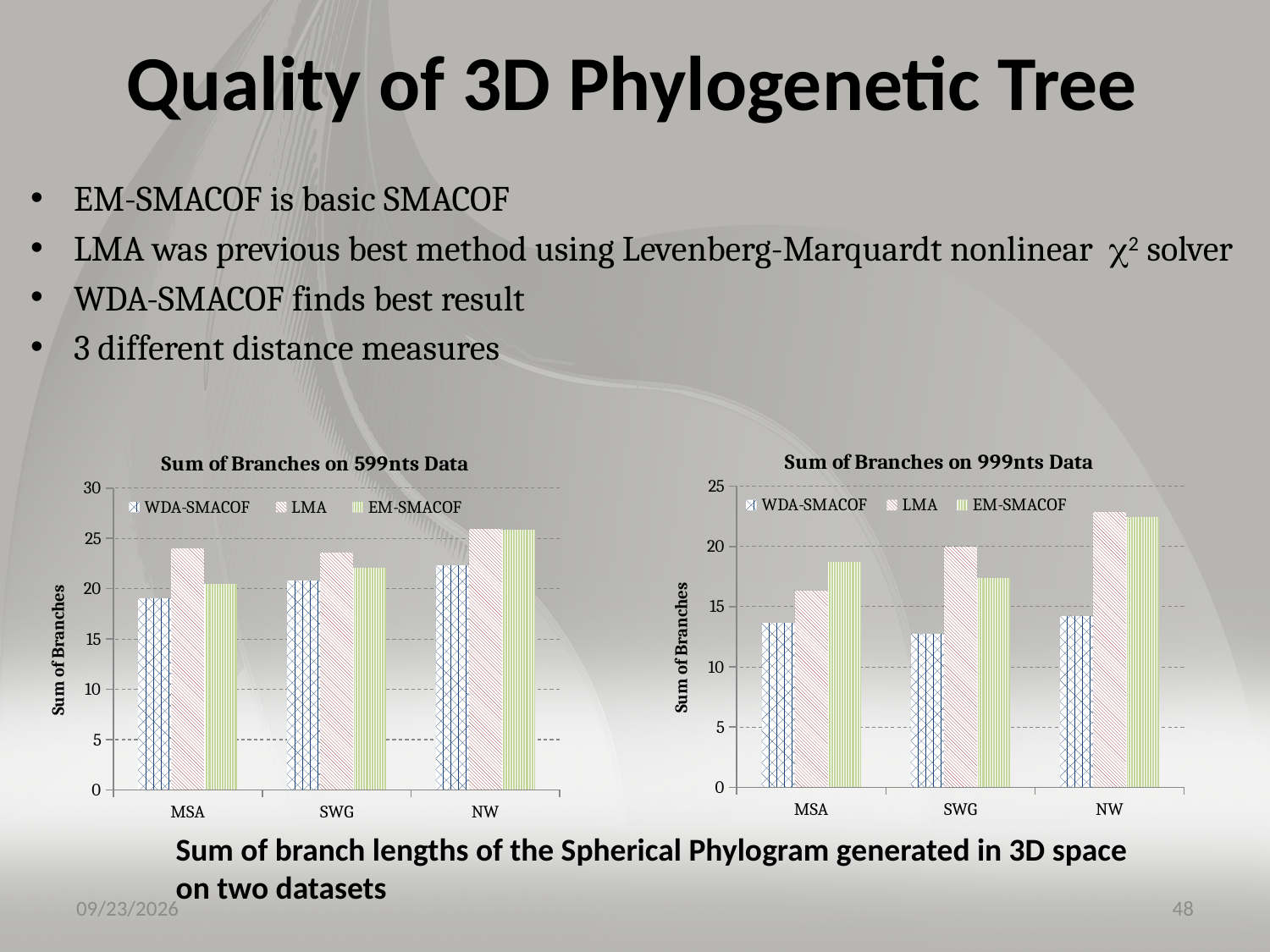
What is the y-axis label of the chart titled "Sum of Branches on 999nts Data"? Sum of Branches In the chart titled "Sum of Branches on 599nts Data", what kind of chart is shown? bar chart In the chart titled "Sum of Branches on 599nts Data", which series has the lowest value at MSA? WDA-SMACOF In the chart titled "Sum of Branches on 599nts Data", which is larger at MSA: LMA or EM-SMACOF? LMA In the chart titled "Sum of Branches on 599nts Data", is the value for WDA-SMACOF at MSA greater or less than 20? less In the chart titled "Sum of Branches on 999nts Data", is the value for WDA-SMACOF at SWG greater or less than 15? less In the chart titled "Sum of Branches on 999nts Data", which series has the highest value at MSA? EM-SMACOF In the chart titled "Sum of Branches on 599nts Data", is the value for LMA at NW greater or less than 25? greater In the chart titled "Sum of Branches on 999nts Data", which is larger at SWG: LMA or WDA-SMACOF? LMA In the chart titled "Sum of Branches on 599nts Data", how many series does the legend list? 3 In the chart titled "Sum of Branches on 999nts Data", how many categories are shown on the x axis? 3